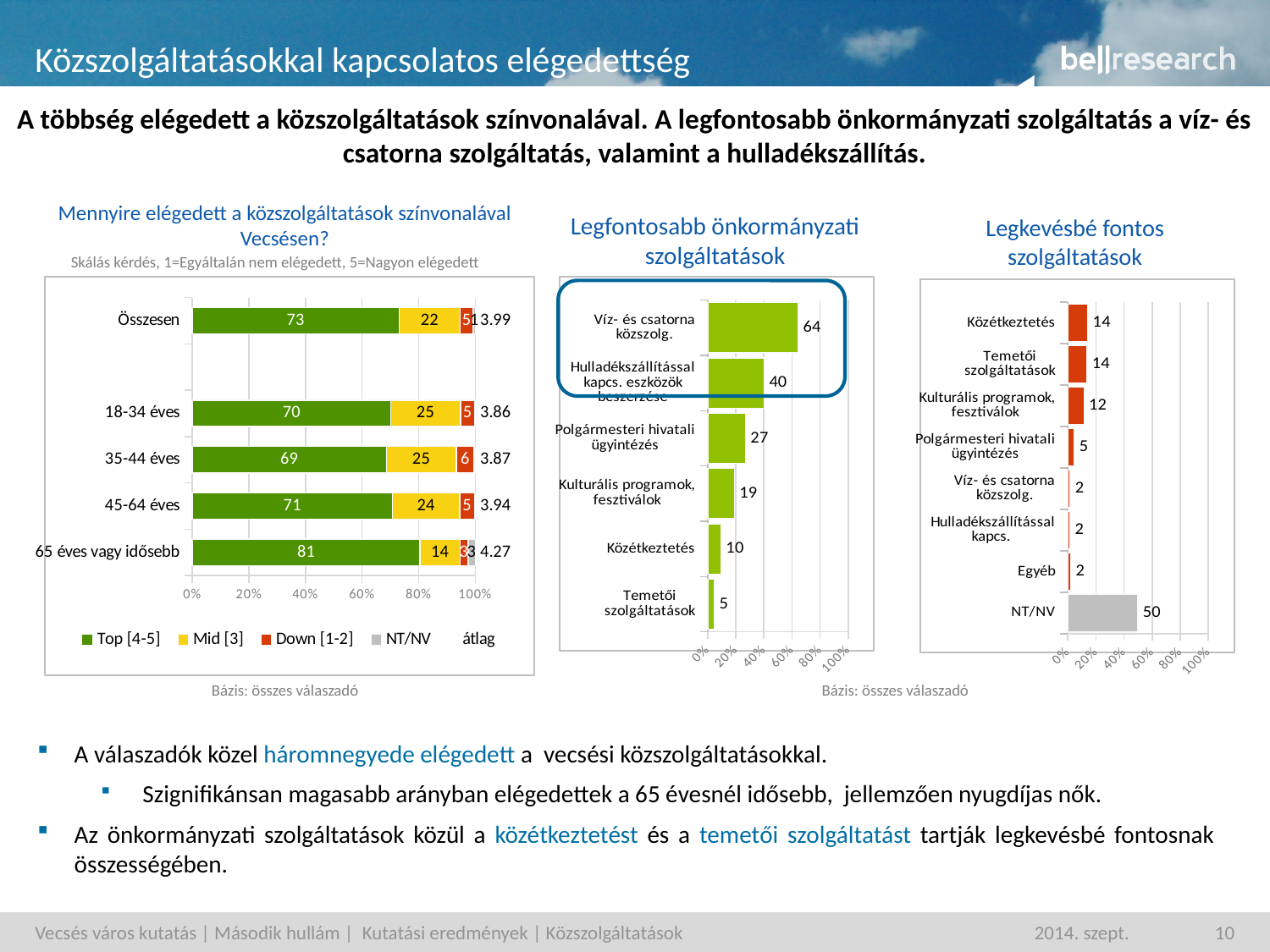
What type of chart is 'Legkevésbé fontos szolgáltatások'? Bar chart In the left chart 'Mennyire elégedett a közszolgáltatások színvonalával Vecsésen?', what is the 'átlag' value for 'Összesen'? 3.99 How many categories are shown in the chart 'Legfontosabb önkormányzati szolgáltatások'? 6 In the chart 'Legkevésbé fontos szolgáltatások', which is larger: 'Közétkeztetés' or 'Polgármesteri hivatali ügyintézés'? Közétkeztetés In the chart 'Legfontosabb önkormányzati szolgáltatások', what is the value for 'Víz- és csatorna közszolg.'? 64 In the chart 'Legfontosabb önkormányzati szolgáltatások', what is the difference between 'Víz- és csatorna közszolg.' and 'Polgármesteri hivatali ügyintézés'? 37 In the chart 'Legkevésbé fontos szolgáltatások', what is the value for 'Kulturális programok, fesztiválok'? 12 In the left chart 'Mennyire elégedett a közszolgáltatások színvonalával Vecsésen?', what is the 'Top [4-5]' value for '65 éves vagy idősebb'? 81 In the chart 'Legfontosabb önkormányzati szolgáltatások', which category has the lowest value? Temetői szolgáltatások How many series does the legend of the left chart 'Mennyire elégedett a közszolgáltatások színvonalával Vecsésen?' list? 5 In the left chart 'Mennyire elégedett a közszolgáltatások színvonalával Vecsésen?', which age group has the highest 'Top [4-5]' value? 65 éves vagy idősebb In the chart 'Legkevésbé fontos szolgáltatások', what is the value for 'NT/NV'? 50